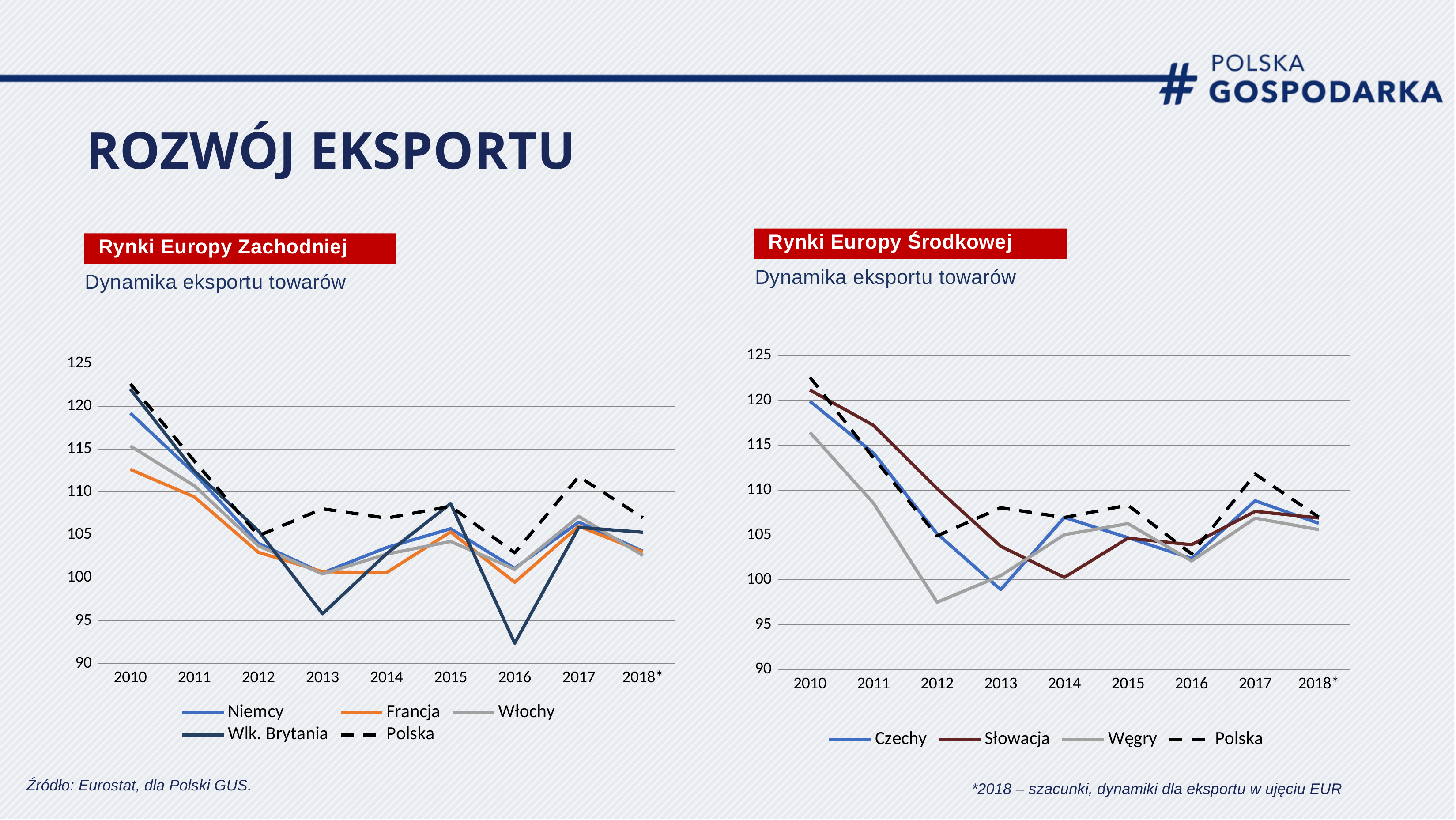
In the 'Rynki Europy Zachodniej' chart, which series has the lowest value in 2016? Wlk. Brytania In the 'Rynki Europy Zachodniej' chart, is the value for Wlk. Brytania in 2016 greater or less than 95? less In the 'Rynki Europy Środkowej' chart, is the value for Węgry in 2012 greater or less than 100? less In the 'Rynki Europy Środkowej' chart, which series is drawn as a dashed line? Polska How many series does the legend of the 'Rynki Europy Zachodniej' chart list? 5 In the 'Rynki Europy Środkowej' chart, does the Czechy line rise or fall from 2010 to 2013? fall In the 'Rynki Europy Zachodniej' chart, which series has the highest value in 2017? Polska In the 'Rynki Europy Środkowej' chart, which series has the lowest value in 2012? Węgry In the 'Rynki Europy Zachodniej' chart, is the value for Polska in 2017 greater or less than 110? greater How many years are shown on the x axis of the 'Rynki Europy Środkowej' chart? 9 How many series does the legend of the 'Rynki Europy Środkowej' chart list? 4 What kind of chart is the 'Rynki Europy Zachodniej' chart? line chart